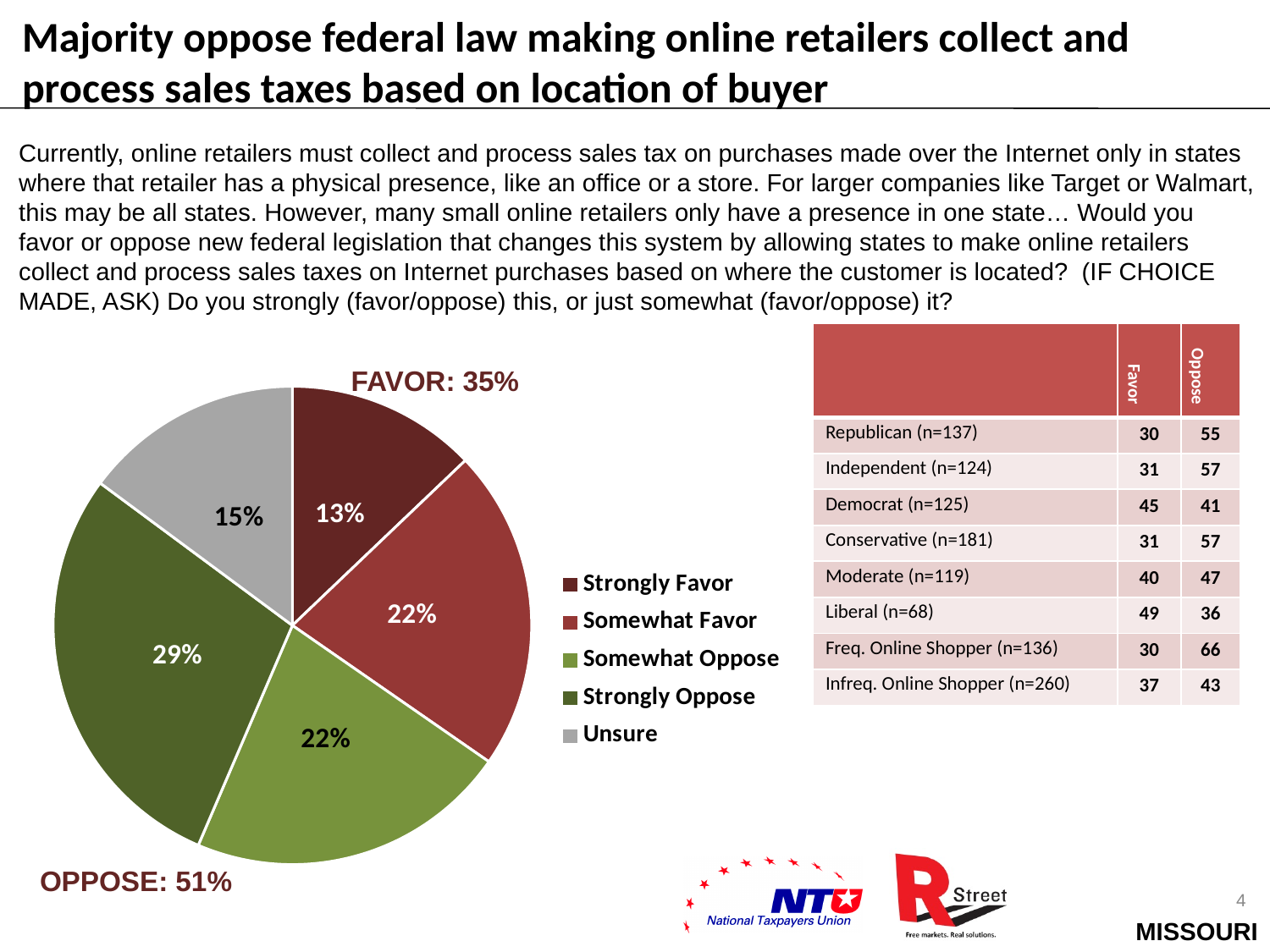
How many entries does the pie chart legend list? 5 What percentage of the pie chart is Somewhat Favor? 22% Which is larger in the pie chart, Unsure or Strongly Favor? Unsure What kind of chart is shown on the slide? pie chart What total percentage does the slide give for OPPOSE next to the pie chart? 51% What percentage of the pie chart is Unsure? 15% How many slices does the pie chart have? 5 What percentage of the pie chart is Strongly Favor? 13% What percentage of the pie chart is Strongly Oppose? 29% Which slice of the pie chart is the largest? Strongly Oppose Which slice of the pie chart is the smallest? Strongly Favor What is the difference in percentage points between Strongly Oppose and Strongly Favor in the pie chart? 16